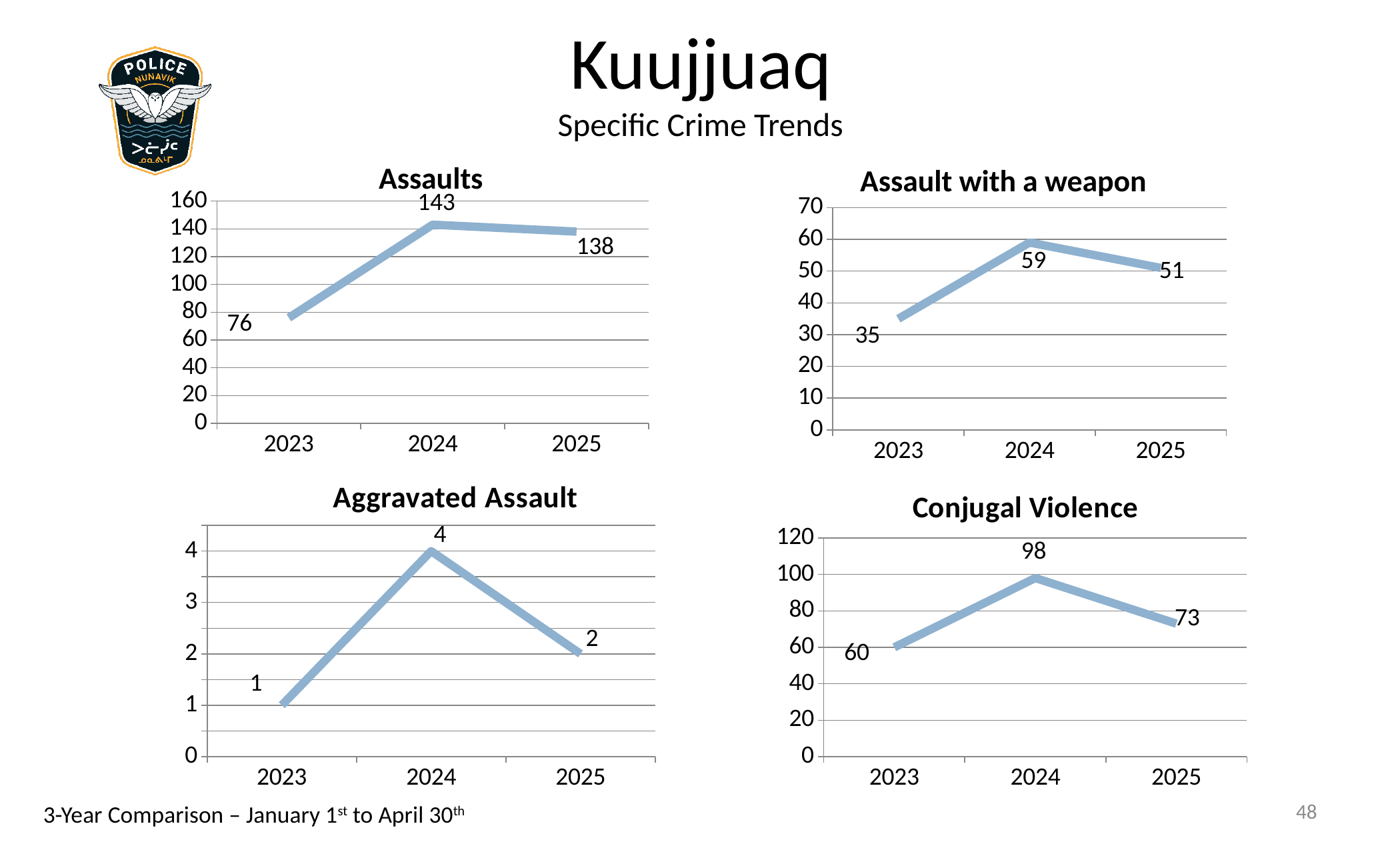
How many years are plotted in the Aggravated Assault chart? 3 In the Conjugal Violence chart, what is the difference between the 2024 and 2025 values? 25 In the Assaults chart, which year has the lowest value? 2023 In the Assaults chart, what is the difference between the 2024 and 2023 values? 67 In the Assault with a weapon chart, which is larger, the value for 2024 or the value for 2025? 2024 In the Aggravated Assault chart, which year has the highest value? 2024 What kind of chart is the Assaults chart? line chart In the Assaults chart, what is the value for 2024? 143 In the Conjugal Violence chart, what is the value for 2025? 73 In the Assault with a weapon chart, what is the value for 2023? 35 In the Conjugal Violence chart, is the value for 2023 greater or less than 80? less In the Aggravated Assault chart, does the value rise or fall from 2024 to 2025? fall